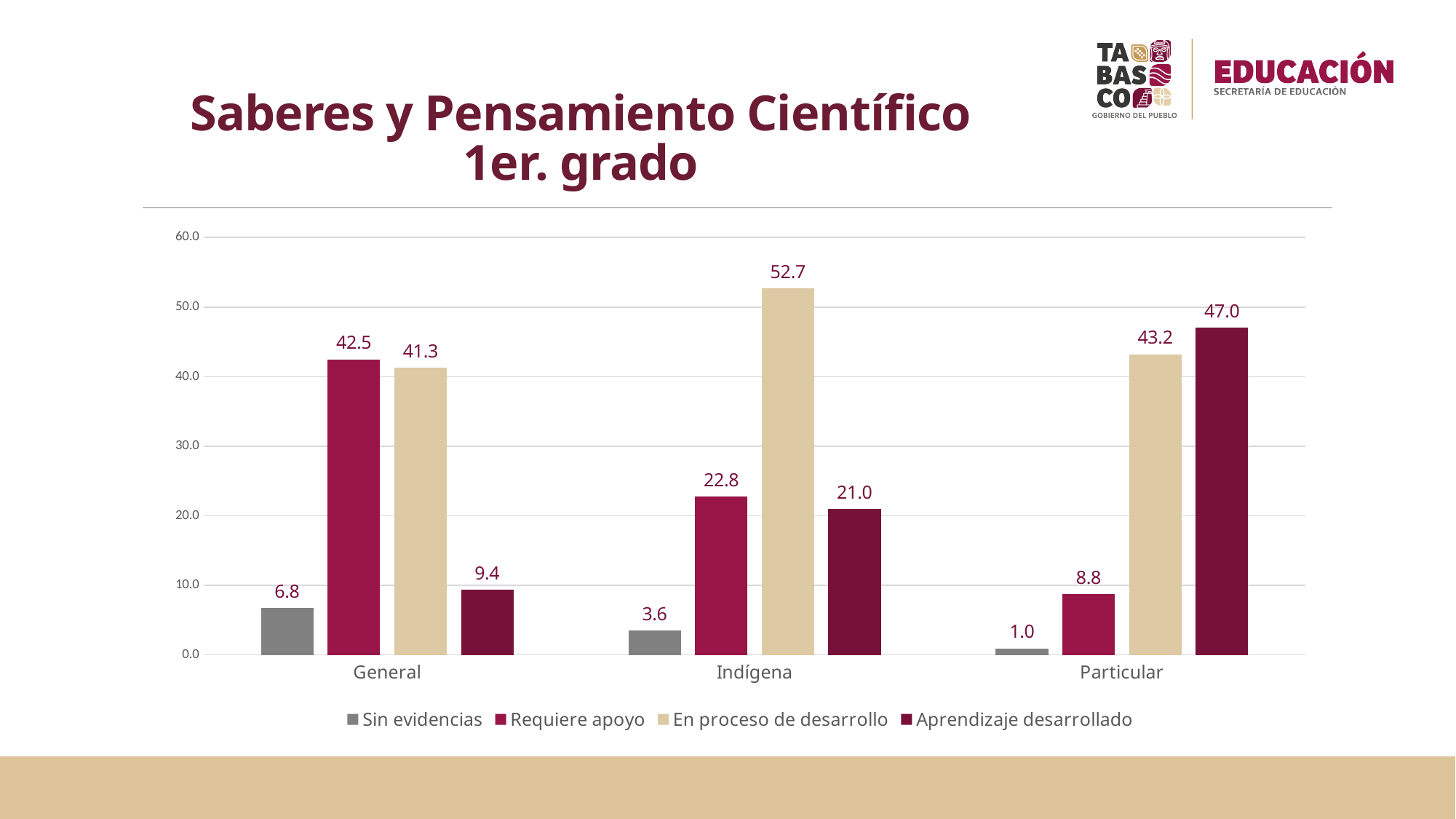
What kind of chart is shown on the slide? Bar chart Which category has the lowest value for "Sin evidencias"? Particular What is the difference between "En proceso de desarrollo" and "Requiere apoyo" in the Indígena category? 29.9 What is the value for "Sin evidencias" in the Particular category? 1.0 How many categories are shown on the x axis? 3 What is the value for "Aprendizaje desarrollado" in the Particular category? 47.0 How many series does the legend list? 4 Which category has the highest value for "Aprendizaje desarrollado"? Particular Which is larger in the General category: "Requiere apoyo" or "En proceso de desarrollo"? Requiere apoyo What is the value for "En proceso de desarrollo" in the Indígena category? 52.7 Does the value for "Sin evidencias" rise or fall from General to Particular? Fall What is the value for "Requiere apoyo" in the General category? 42.5